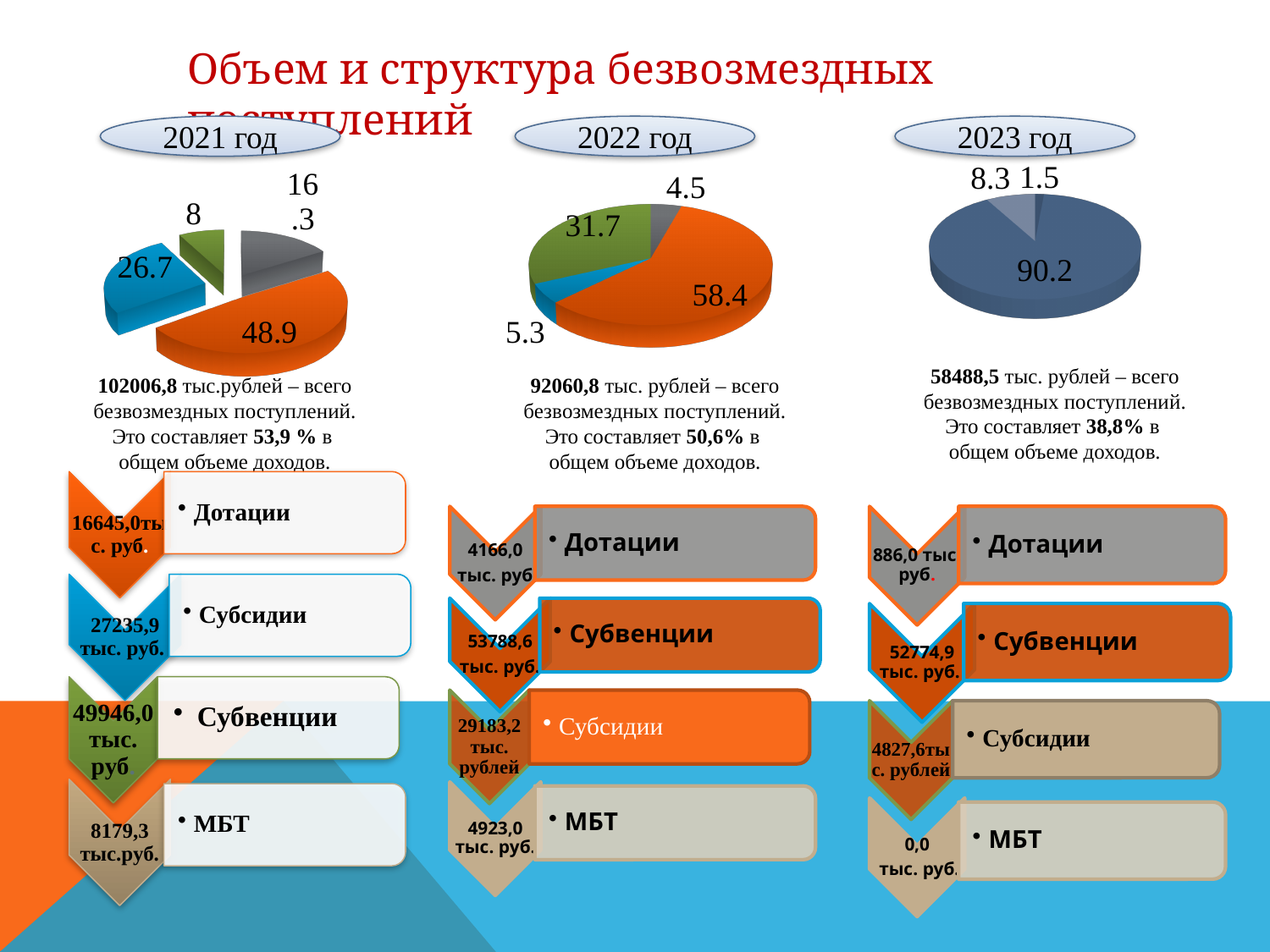
In the "2021 год" pie chart, what is the value of the smallest slice? 8 In the "2023 год" pie chart, how many slices are there? 3 Which of the three pie charts has the fewest slices? 2023 год In the "2023 год" pie chart, what is the value of the largest slice? 90.2 In the "2021 год" pie chart, what is the value of the largest slice? 48.9 In the "2022 год" pie chart, how many slices are there? 4 What kind of chart is shown under the "2021 год" label? pie chart In the "2022 год" pie chart, what is the value of the largest slice? 58.4 In the "2021 год" pie chart, how many slices are there? 4 Which of the three pie charts (2021, 2022 or 2023) contains the single largest slice? 2023 год In the "2023 год" pie chart, what is the difference between the largest slice (90.2) and the smallest slice (1.5)? 88.7 In the "2022 год" pie chart, what is the value of the smallest slice? 4.5